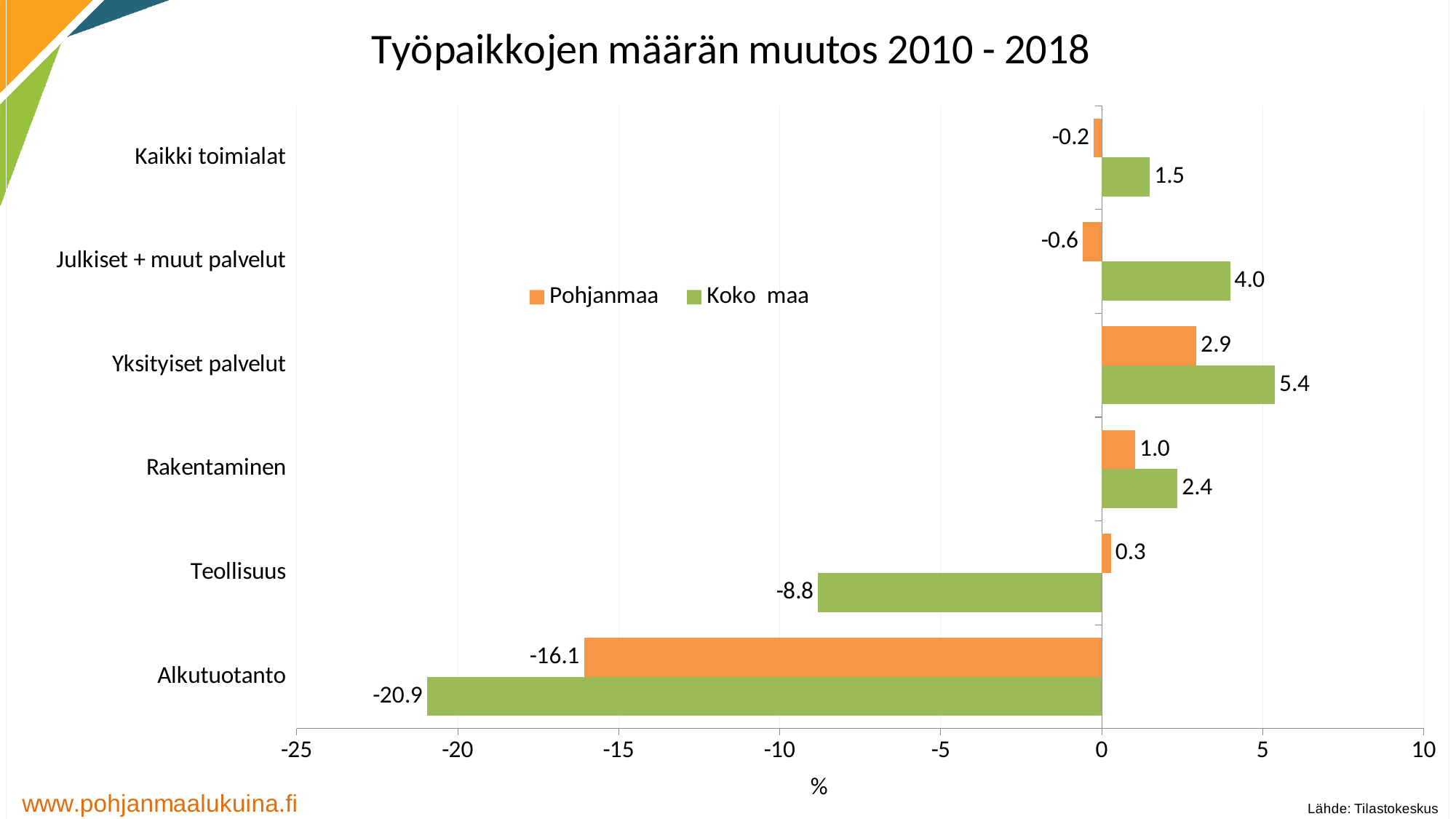
Which is larger for Rakentaminen, the Pohjanmaa value or the Koko maa value? Koko maa What kind of chart is shown on the slide? Bar chart What is the value for Koko maa in the Teollisuus category? -8.8 How many series does the legend list? 2 What is the title of the chart? Työpaikkojen määrän muutos 2010 - 2018 How many categories are shown on the chart? 6 What is the value for Pohjanmaa in the Kaikki toimialat category? -0.2 What is the difference between the Koko maa and Pohjanmaa values for Julkiset + muut palvelut? 4.6 Which category has the highest value for Pohjanmaa? Yksityiset palvelut What is the value for Pohjanmaa in the Alkutuotanto category? -16.1 What is the value for Koko maa in the Yksityiset palvelut category? 5.4 Which category has the lowest value for Koko maa? Alkutuotanto